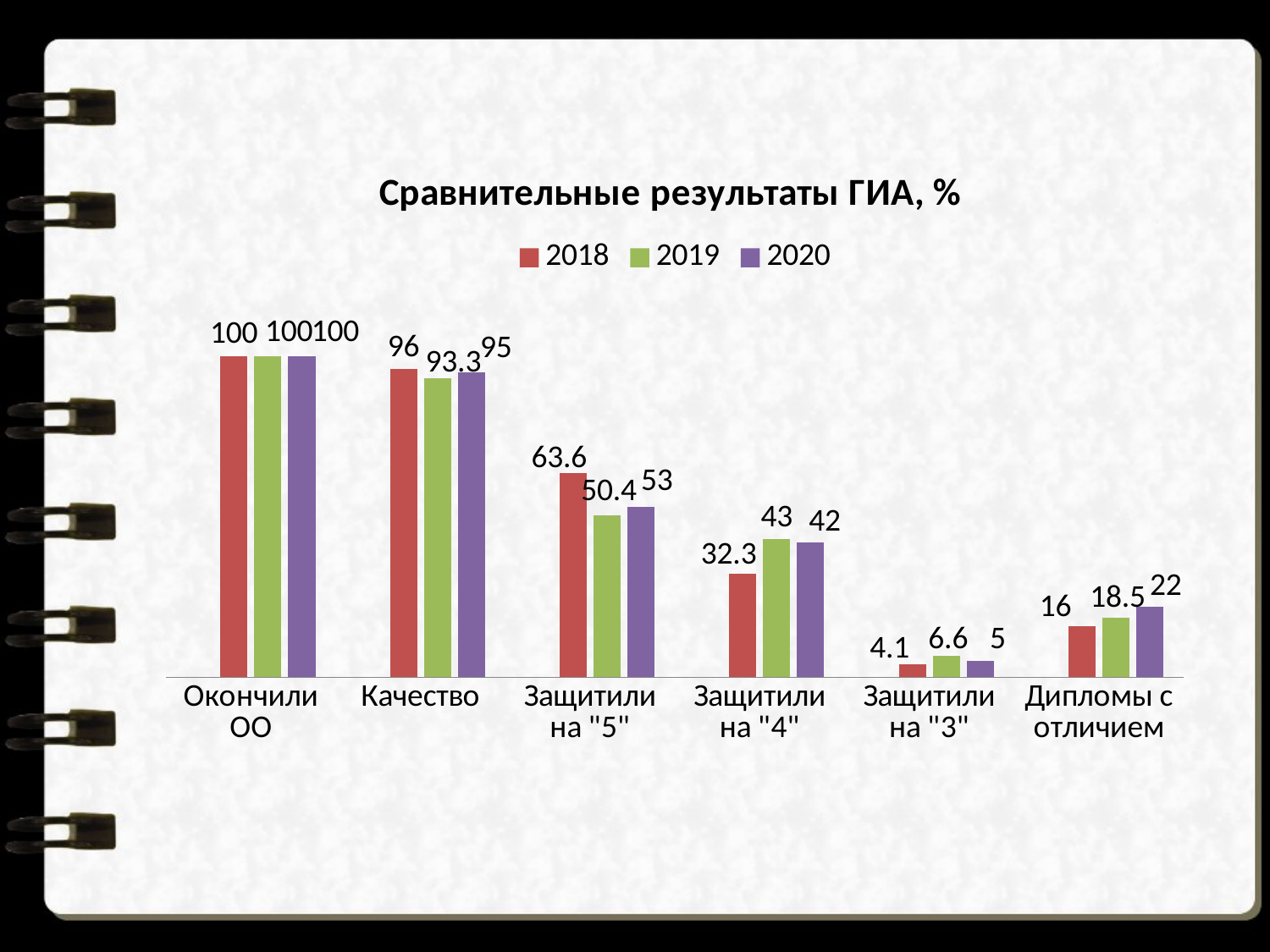
What is the value for 2020 in the "Дипломы с отличием" category? 22 What is the title of the chart? Сравнительные результаты ГИА, % Which year has the highest value in the "Защитили на "3"" category? 2019 Which is larger in the "Дипломы с отличием" category: the 2019 value or the 2020 value? 2020 How many series does the legend list? 3 Which year has the lowest value in the "Защитили на "5"" category? 2019 How many categories are shown on the x axis? 6 What kind of chart is shown on the slide? bar chart What is the value for 2019 in the "Качество" category? 93.3 What is the value for 2018 in the "Защитили на "4"" category? 32.3 What is the value for 2018 in the "Защитили на "5"" category? 63.6 What is the difference between the 2018 and 2020 values in the "Защитили на "5"" category? 10.6